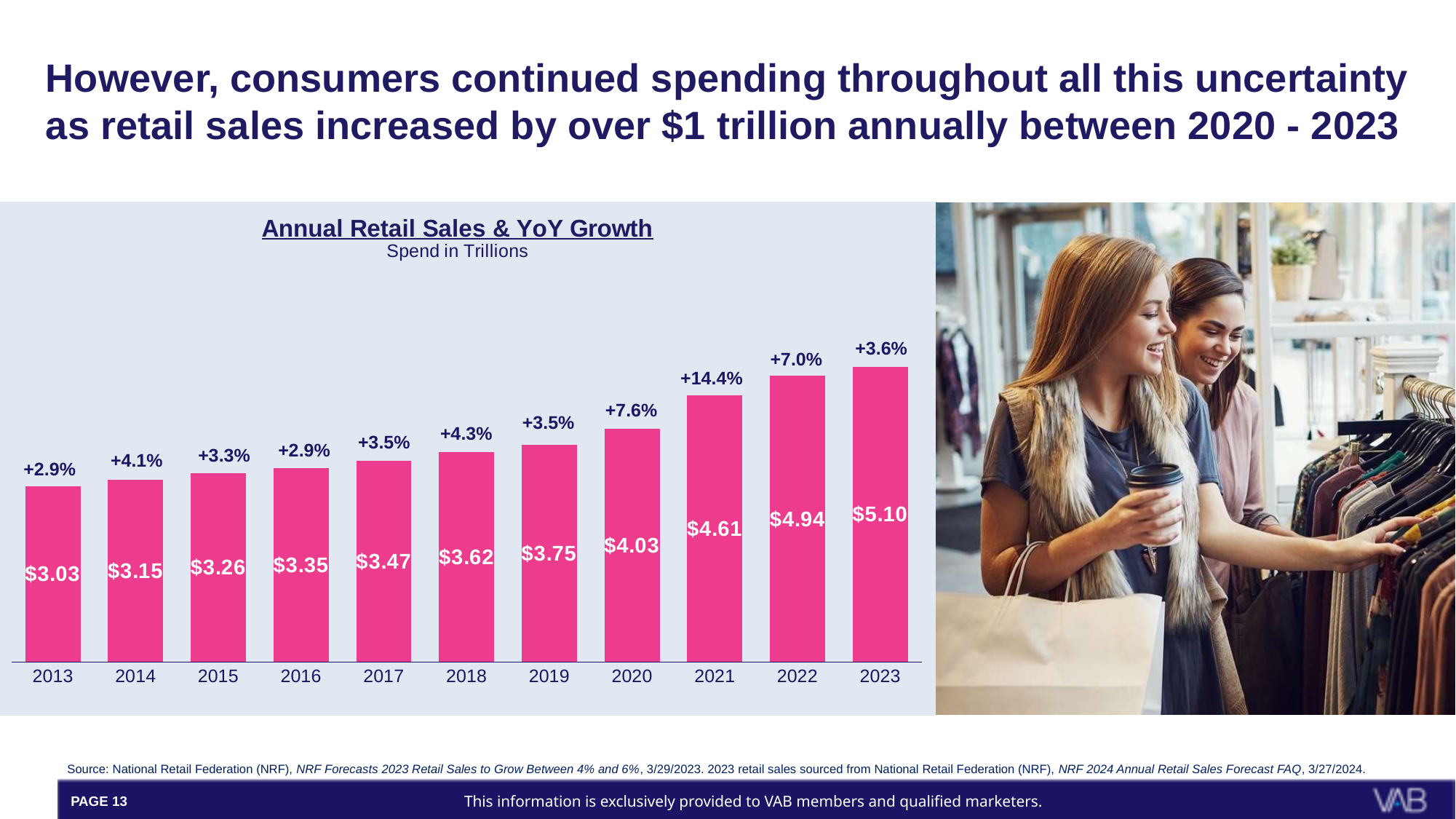
Which year has the lowest annual retail sales? 2013 How many years are shown on the x axis of the chart? 11 Which year has the highest annual retail sales? 2023 Which year had higher retail sales, 2018 or 2019? 2019 What is the title of the chart? Annual Retail Sales & YoY Growth What was the annual retail sales value in 2016? $3.35 What unit does the chart subtitle say the spend is in? Trillions Do the annual retail sales values rise or fall from 2013 to 2023? Rise What YoY growth percentage is shown above the 2021 bar? +14.4% What kind of chart is used to show Annual Retail Sales & YoY Growth? Bar chart What was the annual retail sales value in 2020? $4.03 What is the difference in retail sales between 2023 and 2020? $1.07